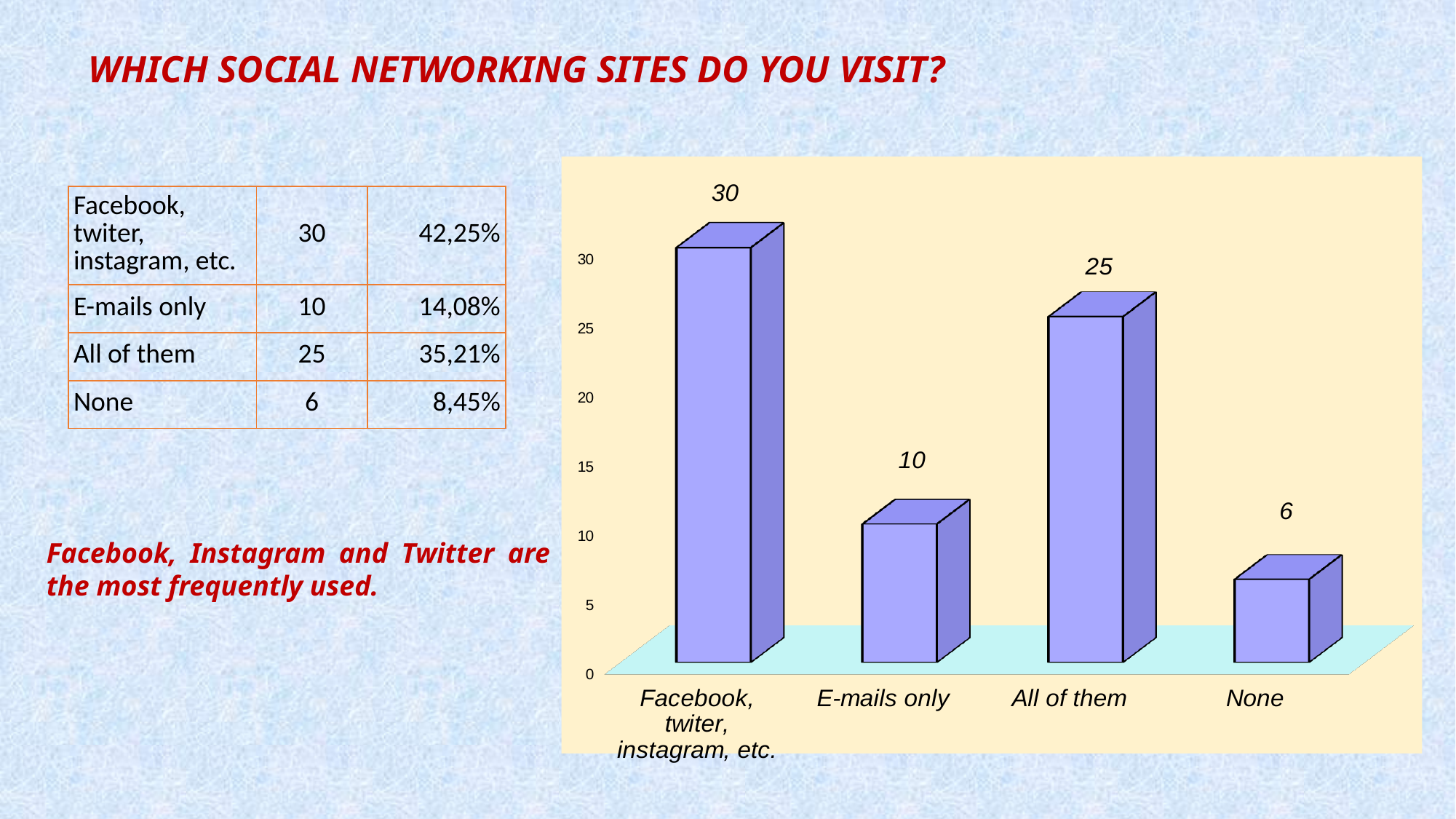
What is the value for "All of them" in the chart? 25 What is the difference between the values for "E-mails only" and "None"? 4 Is the value for "None" greater or less than 10? less Which is larger, the value for "All of them" or the value for "E-mails only"? All of them Which category has the highest value in the chart? Facebook, twiter, instagram, etc. How many categories are shown in the chart? 4 What is the value for "None" in the chart? 6 What kind of chart is shown on the slide? bar chart What is the value for "E-mails only" in the chart? 10 What is the title of the slide containing the chart? WHICH SOCIAL NETWORKING SITES DO YOU VISIT? What is the difference between the values for "Facebook, twiter, instagram, etc." and "All of them"? 5 Which category has the lowest value in the chart? None